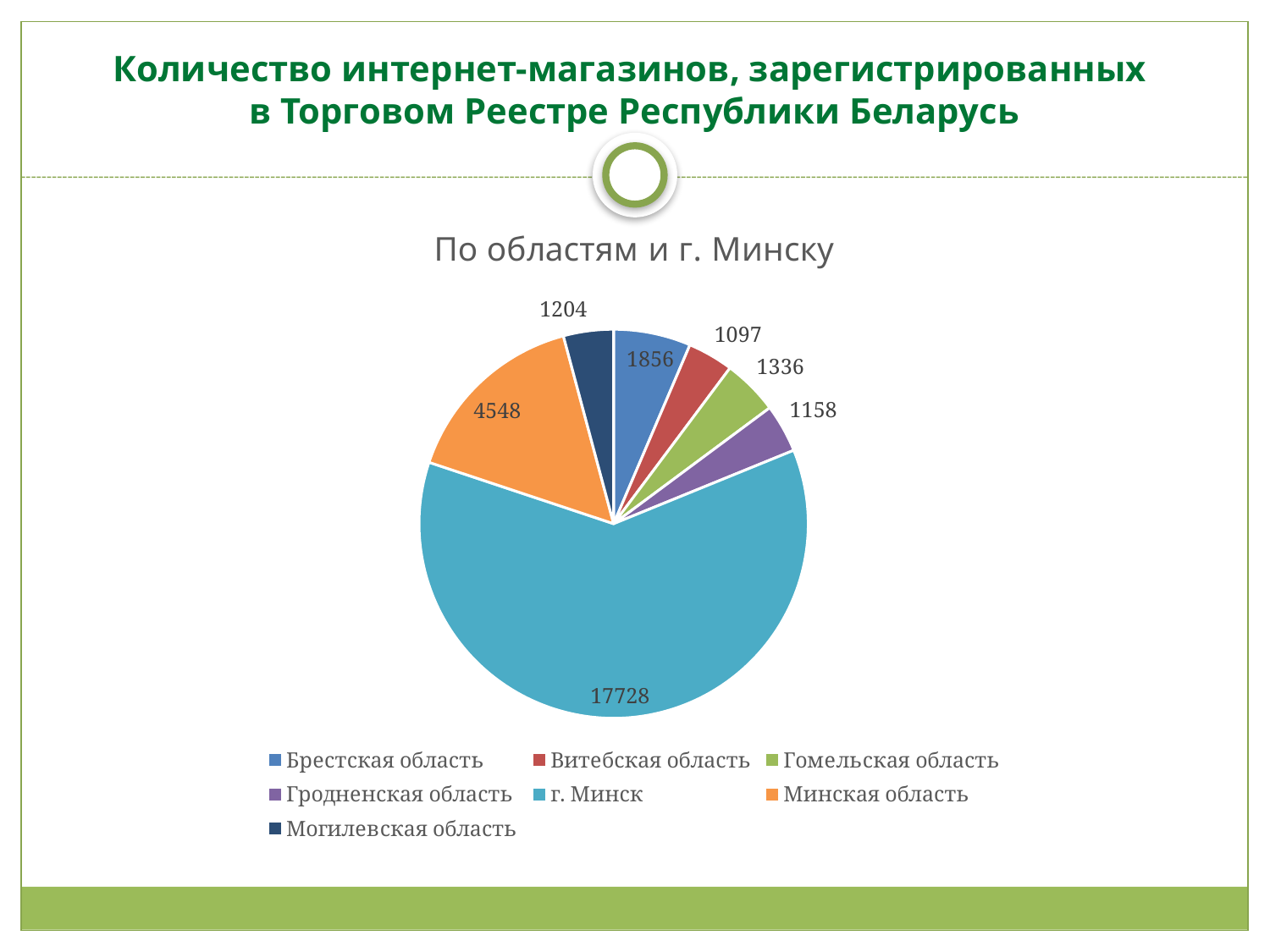
What is the value for г. Минск? 17728 What is the title of the chart? По областям и г. Минску How many slices does the pie chart have? 7 What is the difference between the values for Минская область and Брестская область? 2692 What is the value for Брестская область? 1856 Which category has the smallest slice? Витебская область What is the value for Витебская область? 1097 What is the value for Могилевская область? 1204 Which is larger, the value for Гомельская область or Гродненская область? Гомельская область What type of chart is shown on the slide? Pie chart Which category has the largest slice? г. Минск What is the value for Минская область? 4548